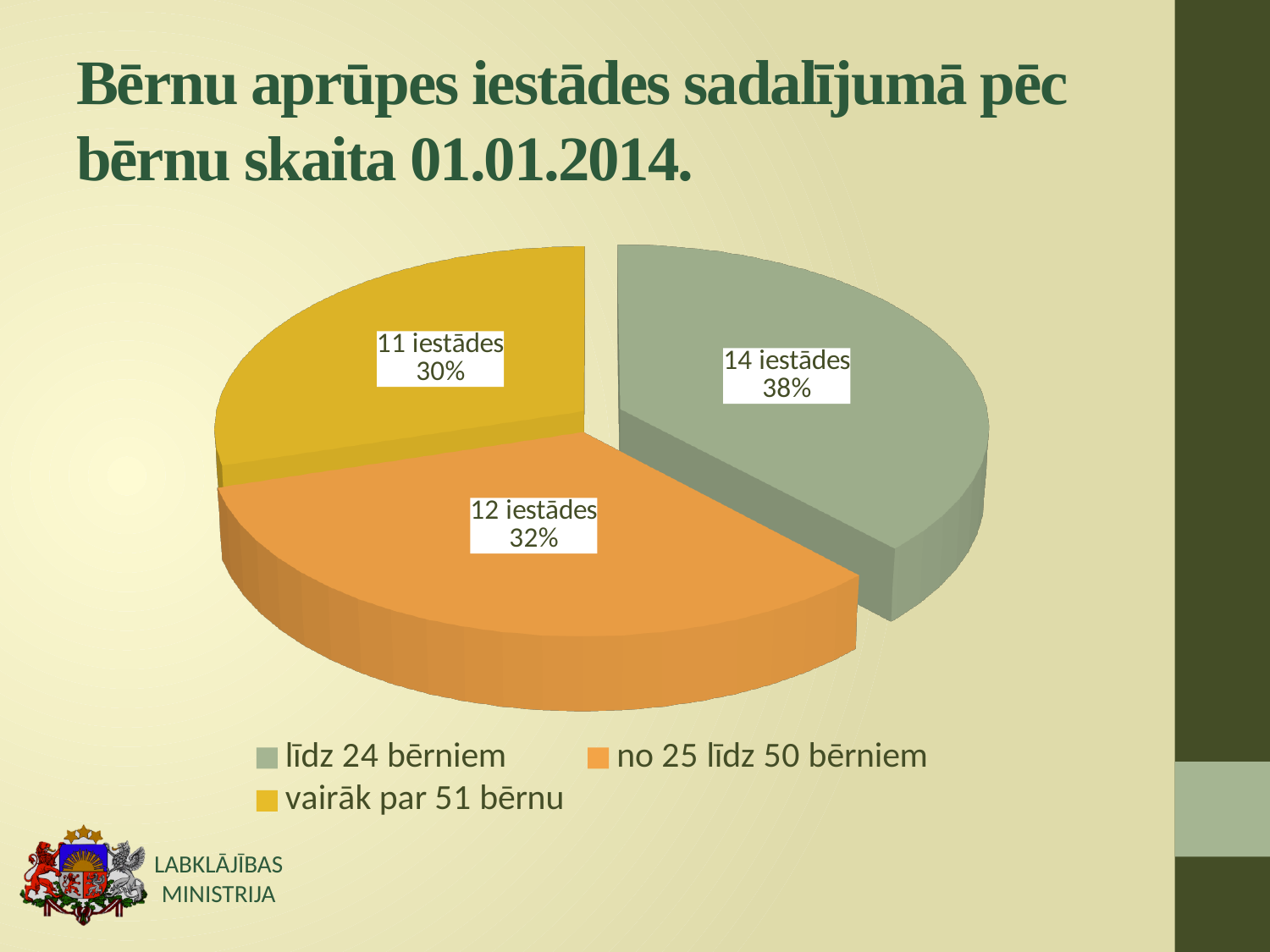
How many institutions (iestādes) are in the 'vairāk par 51 bērnu' category? 11 iestādes What percentage share does the slice for 'līdz 24 bērniem' have? 38% What kind of chart is shown on the slide? pie chart How many slices does the pie chart have? 3 What is the difference in the number of institutions between 'līdz 24 bērniem' and 'vairāk par 51 bērnu'? 3 What percentage share does the slice for 'no 25 līdz 50 bērniem' have? 32% What is the title of the chart on the slide? Bērnu aprūpes iestādes sadalījumā pēc bērnu skaita 01.01.2014. What percentage share does the slice for 'vairāk par 51 bērnu' have? 30% Which category has the largest slice of the pie? līdz 24 bērniem How many entries does the legend list? 3 How many institutions (iestādes) are in the 'līdz 24 bērniem' category? 14 iestādes Which category has the smallest slice of the pie? vairāk par 51 bērnu